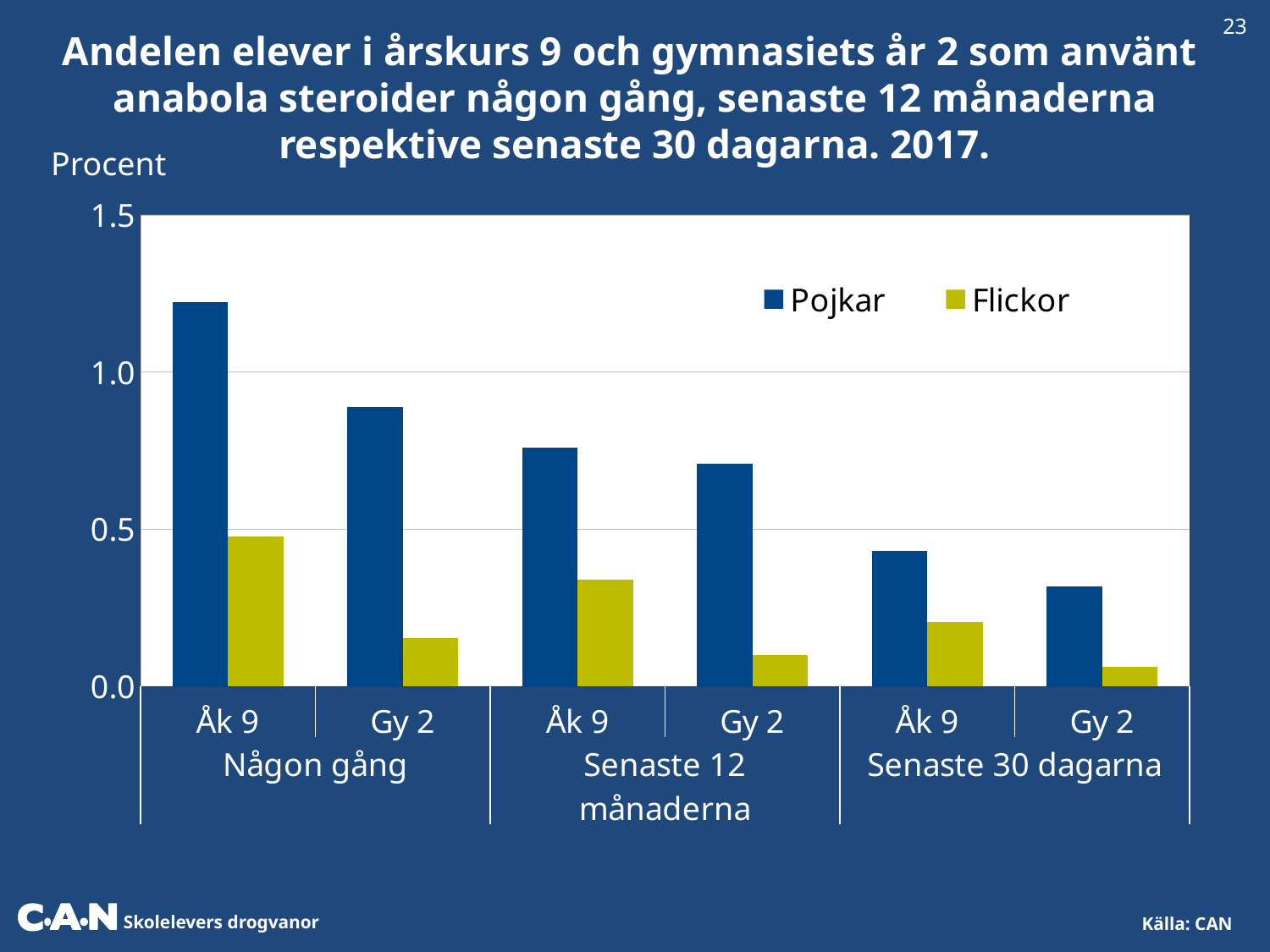
What are the two series named in the legend? Pojkar and Flickor Do the Pojkar values rise or fall moving from Någon gång to Senaste 30 dagarna along the x axis? fall How many category groups (bar pairs) are shown along the x axis? 6 Which bar is the lowest in the chart? Flickor, Gy 2, Senaste 30 dagarna Is the value for Pojkar in Åk 9 under Senaste 30 dagarna greater or less than 0.5? less Is the value for Pojkar in Gy 2 under Någon gång greater or less than 1.0? less How many series does the legend list? 2 What kind of chart is shown on the slide? bar chart Is the value for Pojkar in Åk 9 under Någon gång greater or less than 1.0? greater Which bar is the highest in the chart? Pojkar, Åk 9, Någon gång Under Senaste 12 månaderna for Gy 2, which is larger, Pojkar or Flickor? Pojkar